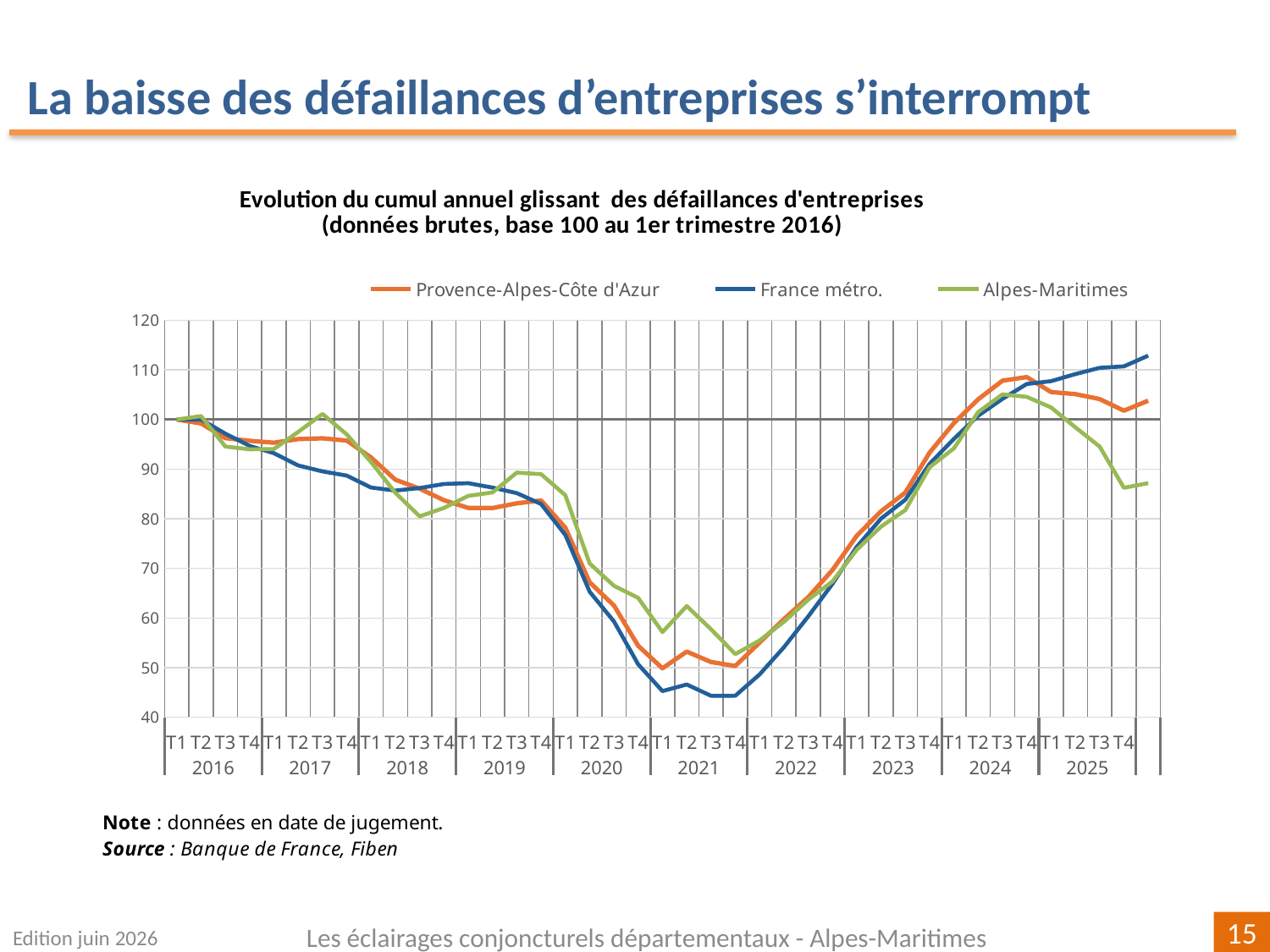
Does the Alpes-Maritimes series rise or fall between T2 2024 and T4 2025? fall What kind of chart is shown on the slide? line chart Which series are listed in the legend? Provence-Alpes-Côte d'Azur, France métro., Alpes-Maritimes Is the value for Alpes-Maritimes at T4 2025 greater or less than 90? less How many years are labelled along the x axis? 10 What is the value of each series at T1 2016, the base period? 100 At T1 2021, which is larger: Alpes-Maritimes or France métro.? Alpes-Maritimes Which series has the highest value at T4 2025? France métro. Which series has the lowest value at T4 2021? France métro. Is the value for France métro. at T4 2021 greater or less than 50? less How many series does the legend list? 3